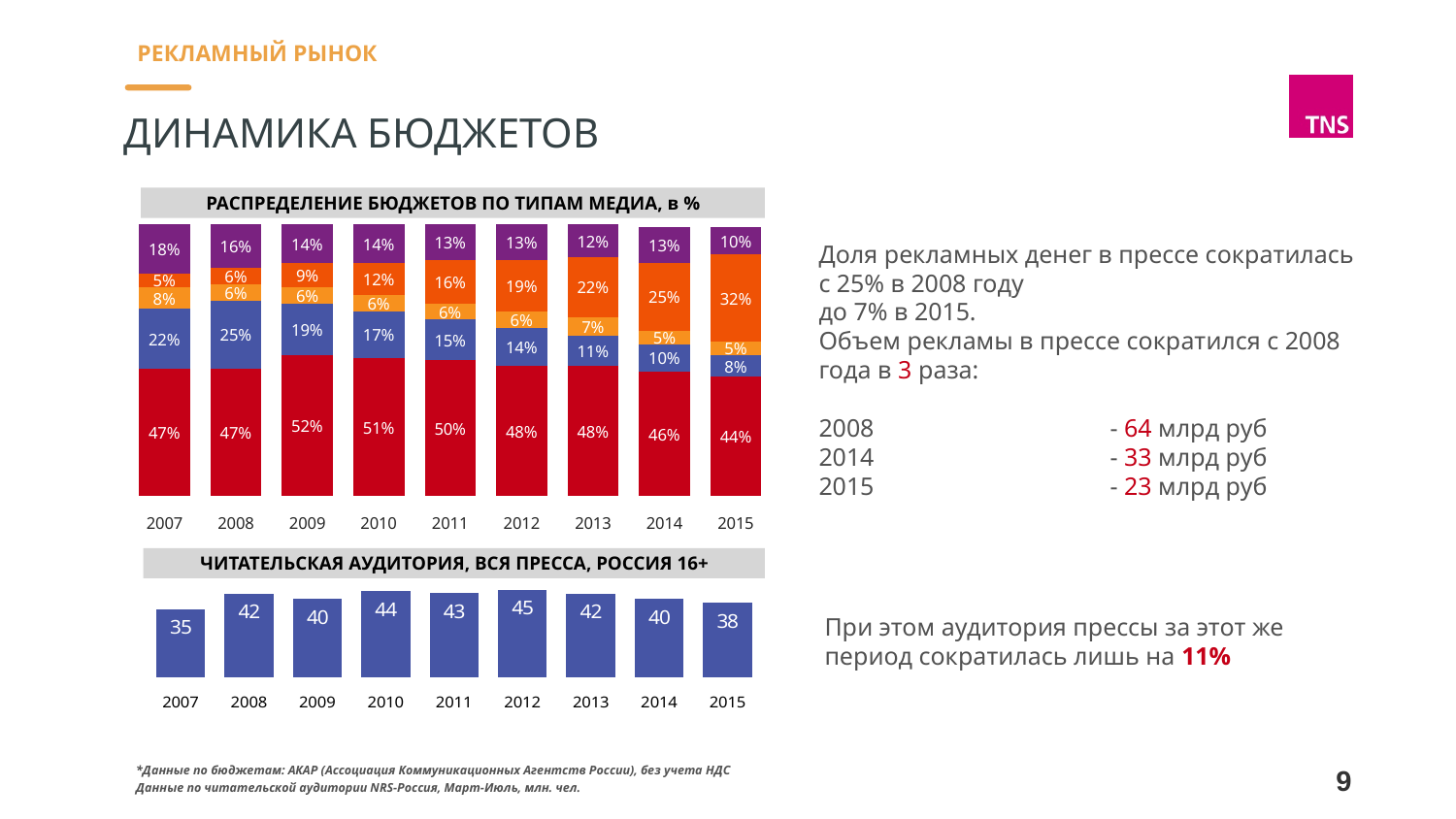
In the chart 'ЧИТАТЕЛЬСКАЯ АУДИТОРИЯ, ВСЯ ПРЕССА, РОССИЯ 16+', which year has the lowest value? 2007 In the chart 'ЧИТАТЕЛЬСКАЯ АУДИТОРИЯ, ВСЯ ПРЕССА, РОССИЯ 16+', what is the difference between the values for 2008 and 2015? 4 In the chart 'РАСПРЕДЕЛЕНИЕ БЮДЖЕТОВ ПО ТИПАМ МЕДИА, в %', what is the value of the purple top segment for 2007? 18% In the chart 'РАСПРЕДЕЛЕНИЕ БЮДЖЕТОВ ПО ТИПАМ МЕДИА, в %', what is the value of the red bottom segment for 2009? 52% In the chart 'ЧИТАТЕЛЬСКАЯ АУДИТОРИЯ, ВСЯ ПРЕССА, РОССИЯ 16+', what is the value for 2012? 45 What kind of chart is 'ЧИТАТЕЛЬСКАЯ АУДИТОРИЯ, ВСЯ ПРЕССА, РОССИЯ 16+'? Bar chart In the chart 'РАСПРЕДЕЛЕНИЕ БЮДЖЕТОВ ПО ТИПАМ МЕДИА, в %', which year has the largest red bottom segment? 2009 How many years are shown in the chart 'ЧИТАТЕЛЬСКАЯ АУДИТОРИЯ, ВСЯ ПРЕССА, РОССИЯ 16+'? 9 In the chart 'ЧИТАТЕЛЬСКАЯ АУДИТОРИЯ, ВСЯ ПРЕССА, РОССИЯ 16+', which year has the highest value? 2012 In the chart 'РАСПРЕДЕЛЕНИЕ БЮДЖЕТОВ ПО ТИПАМ МЕДИА, в %', what is the value of the orange segment for 2015? 32% In the chart 'РАСПРЕДЕЛЕНИЕ БЮДЖЕТОВ ПО ТИПАМ МЕДИА, в %', which year has the larger red bottom segment, 2007 or 2015? 2007 In the chart 'РАСПРЕДЕЛЕНИЕ БЮДЖЕТОВ ПО ТИПАМ МЕДИА, в %', does the purple top segment rise or fall from 2007 to 2015? Fall